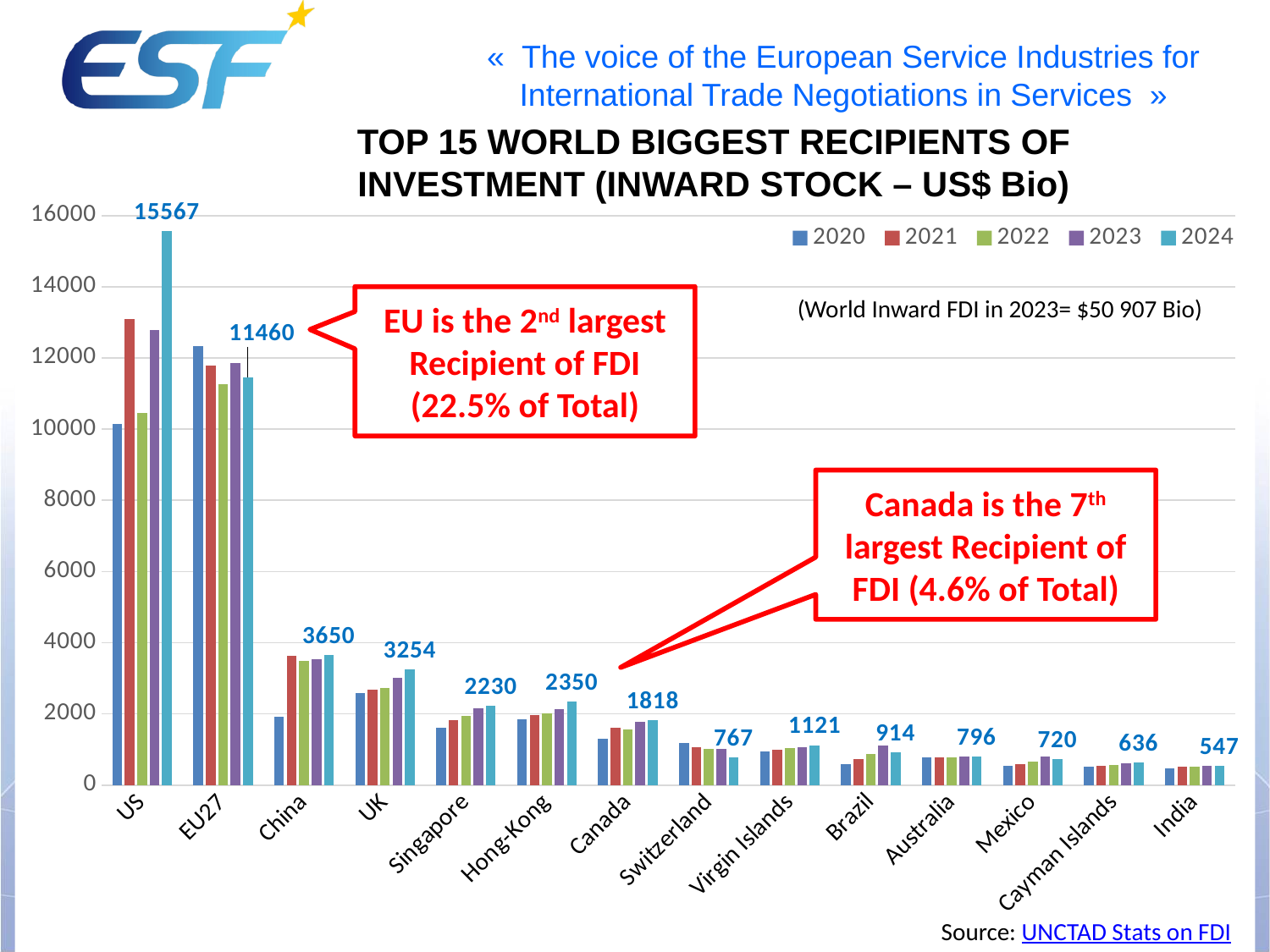
What is the 2024 value labelled for Virgin Islands? 1121 How many series does the legend list? 5 Is the 2021 value for EU27 greater or less than 10000? greater What is the difference between the 2024 values for Brazil and Australia? 118 Which recipient has the lowest 2024 value on the chart? India Which recipient has the highest 2024 value on the chart? US What is the 2024 inward FDI stock value shown for the US? 15567 What is the 2024 value labelled for Canada? 1818 What kind of chart is shown on the slide? bar chart Which has the larger 2024 value, Hong-Kong or Singapore? Hong-Kong Which years are listed in the chart legend? 2020, 2021, 2022, 2023, 2024 What is the difference between the 2024 values for the US and EU27? 4107